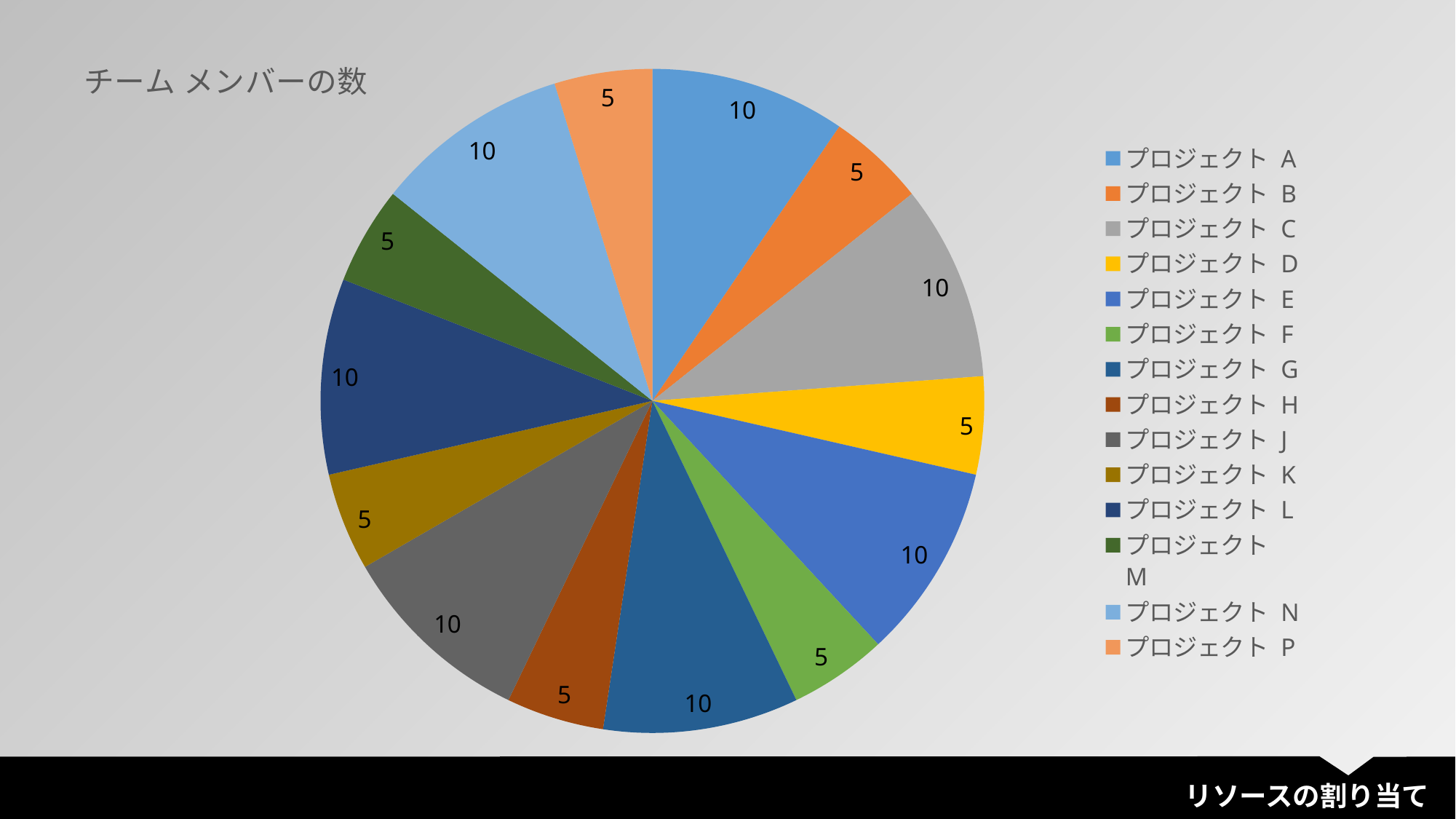
What is the value for プロジェクト G? 10 Which is larger, the value for プロジェクト C or the value for プロジェクト D? プロジェクト C What is the total of all the slices in the pie chart? 105 Which legend entry is shown in yellow? プロジェクト D How many categories (slices) does the pie chart have? 14 What is the difference between the value for プロジェクト E and the value for プロジェクト F? 5 What is the title of the chart? チーム メンバーの数 What is the value for プロジェクト P? 5 What kind of chart is shown on the slide? pie chart What is the value for プロジェクト D? 5 What is the value for プロジェクト A? 10 What is the value for プロジェクト B? 5